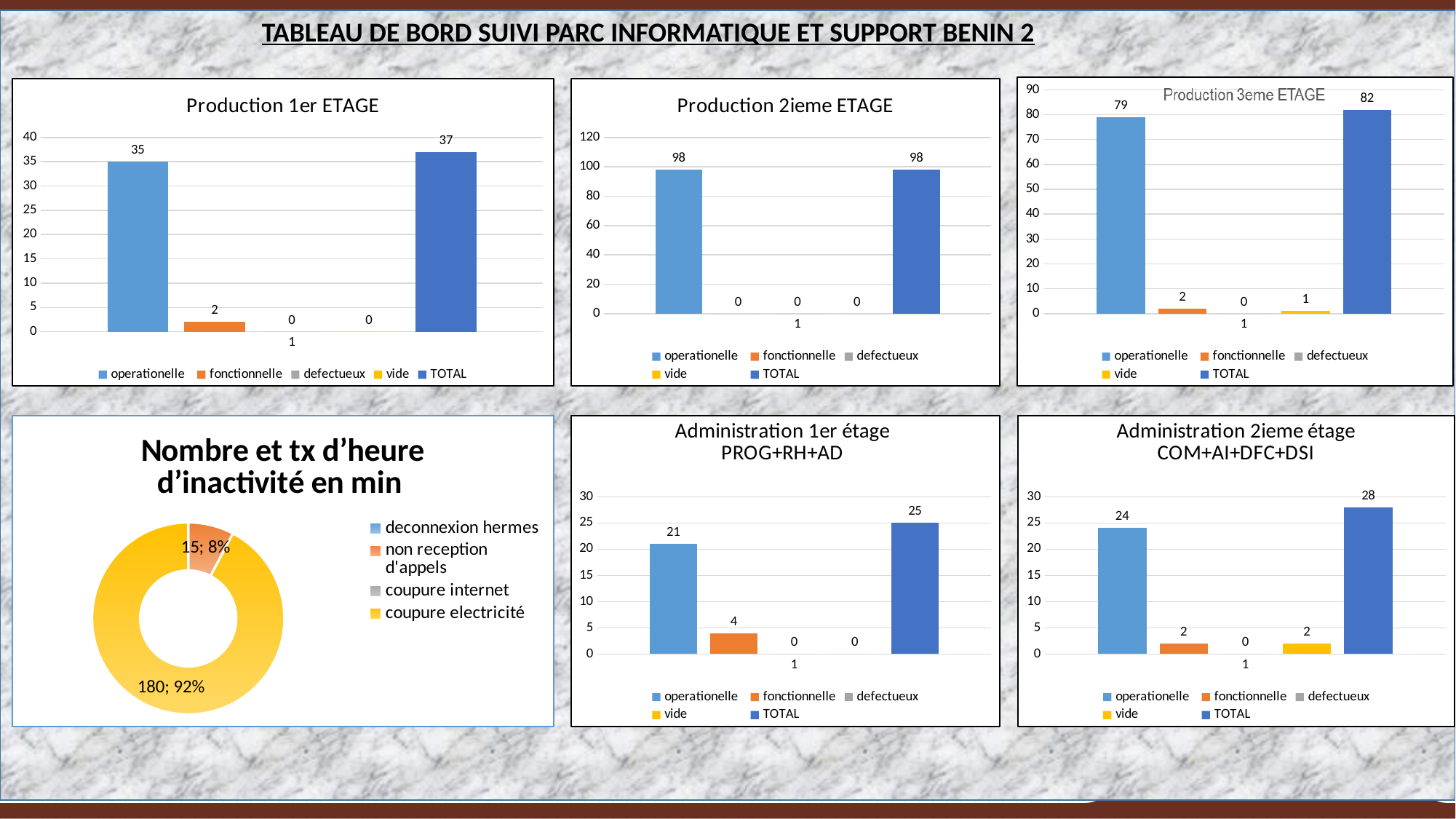
In the Production 1er ETAGE chart, what is the value for operationelle? 35 In the Administration 2ieme étage COM+AI+DFC+DSI chart, which series has the highest value? TOTAL In the Administration 1er étage PROG+RH+AD chart, which is larger, operationelle or fonctionnelle? operationelle In the Production 2ieme ETAGE chart, what is the value for operationelle? 98 In the Production 1er ETAGE chart, what is the value for TOTAL? 37 In the Administration 2ieme étage COM+AI+DFC+DSI chart, is the value for operationelle greater or less than 20? greater In the Production 3eme ETAGE chart, what is the difference between TOTAL and operationelle? 3 How many series does the legend of the Production 2ieme ETAGE chart list? 5 In the Administration 1er étage PROG+RH+AD chart, what is the value for fonctionnelle? 4 In the Production 3eme ETAGE chart, what is the value for vide? 1 What kind of chart is the Nombre et tx d'heure d'inactivité en min chart? doughnut chart In the Nombre et tx d'heure d'inactivité en min chart, what share does coupure electricité have? 92%